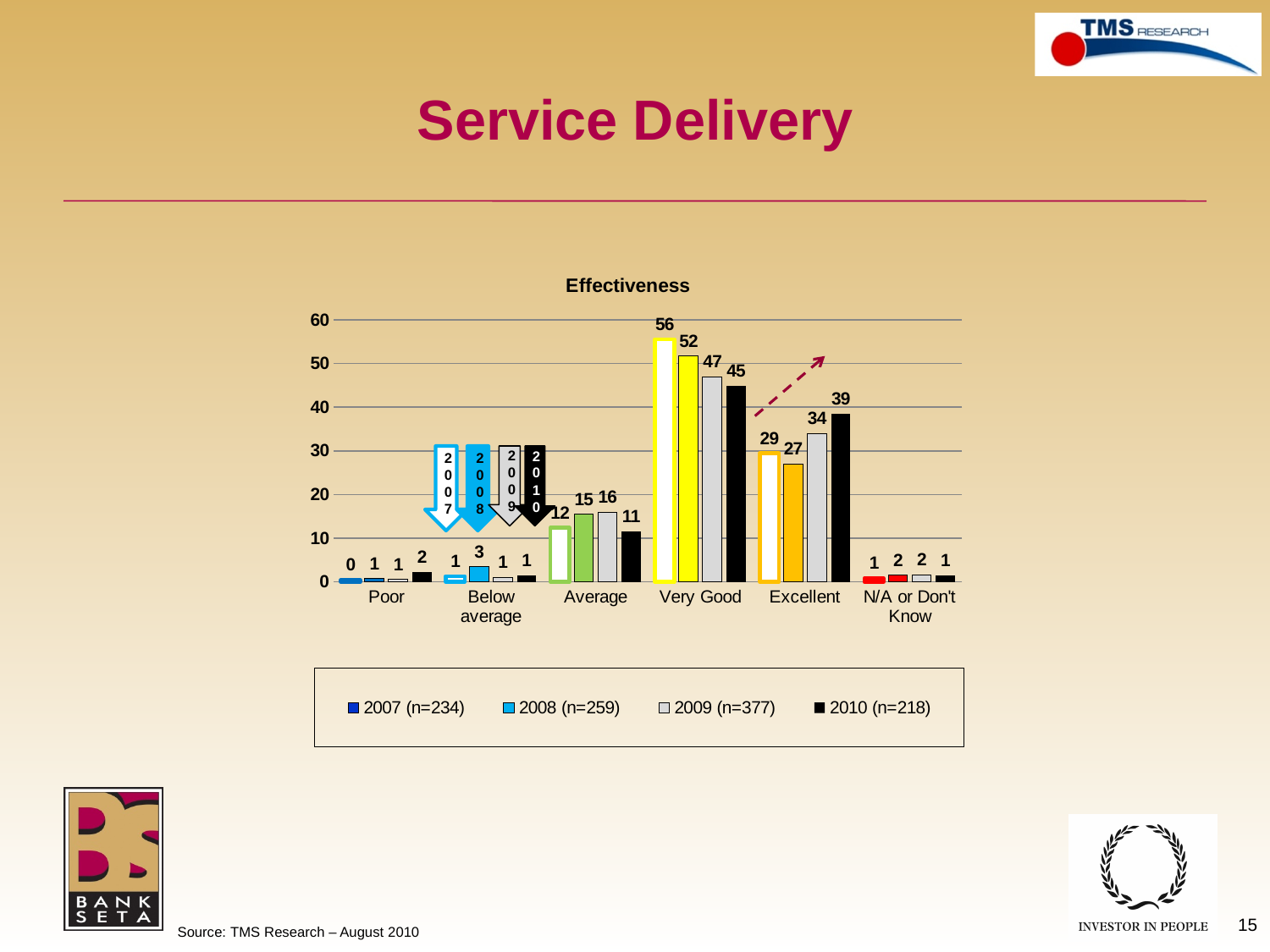
What is the 2009 (n=377) value for Average in the Effectiveness chart? 16 How many series does the legend of the Effectiveness chart list? 4 What is the title of the chart on the slide? Effectiveness In the Effectiveness chart, do the Very Good values rise or fall from 2007 to 2010? Fall What is the 2007 (n=234) value for Very Good in the Effectiveness chart? 56 What is the difference between the 2007 (n=234) and 2010 (n=218) values for Very Good in the Effectiveness chart? 11 What kind of chart is the Effectiveness chart? Bar chart What is the 2010 (n=218) value for Excellent in the Effectiveness chart? 39 How many categories are shown on the x axis of the Effectiveness chart? 6 Which category has the highest 2008 (n=259) value in the Effectiveness chart? Very Good In the Effectiveness chart, is the 2009 (n=377) value for Excellent larger than the 2008 (n=259) value for Excellent? Yes Which category has the lowest 2007 (n=234) value in the Effectiveness chart? Poor